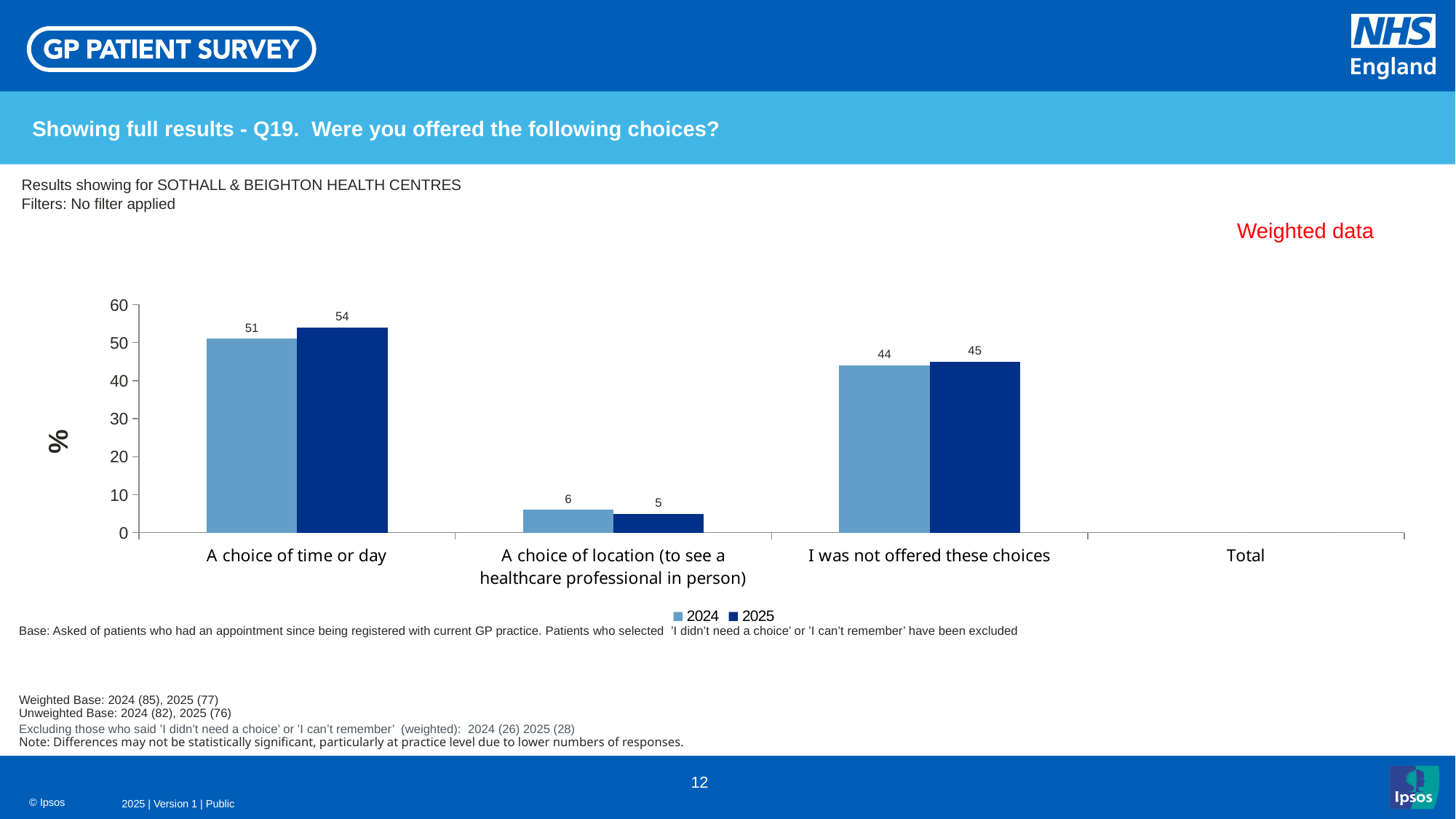
What is the 2025 value for 'A choice of time or day'? 54 What is the 2024 value for 'A choice of location (to see a healthcare professional in person)'? 6 Is the 2025 value for 'I was not offered these choices' greater or less than 40? greater How many series does the legend list? 2 Which is larger for 'A choice of location (to see a healthcare professional in person)': the 2024 value or the 2025 value? 2024 What is the 2024 value for 'I was not offered these choices'? 44 Which category has the lowest 2024 value? A choice of location (to see a healthcare professional in person) Which category has the highest 2025 value? A choice of time or day What is the maximum value shown on the vertical axis? 60 What kind of chart is shown on the slide? Bar chart What is the difference between the 2025 and 2024 values for 'A choice of time or day'? 3 What is the label on the vertical axis? %